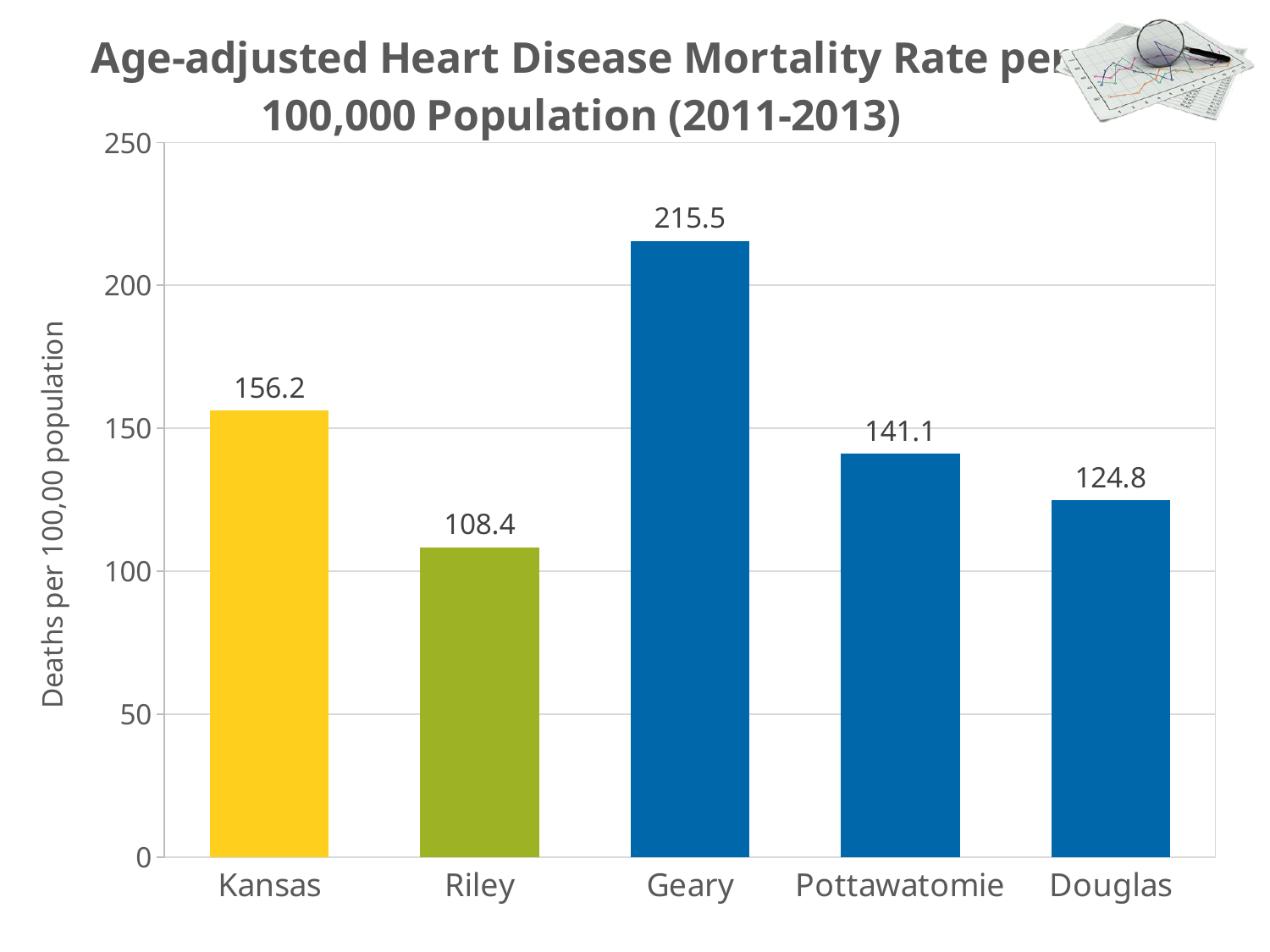
What is the difference between the mortality rates for Geary and Riley? 107.1 What is the age-adjusted heart disease mortality rate for Geary? 215.5 How many categories are shown on the x axis? 5 Which category has the highest heart disease mortality rate? Geary What is the difference between the mortality rates for Kansas and Pottawatomie? 15.1 What kind of chart is shown on the slide? bar chart Which has a higher mortality rate, Pottawatomie or Douglas? Pottawatomie What is the age-adjusted heart disease mortality rate for Kansas? 156.2 What is the age-adjusted heart disease mortality rate for Douglas? 124.8 What is the age-adjusted heart disease mortality rate for Riley? 108.4 Which category has the lowest heart disease mortality rate? Riley Is the value for Geary greater or less than 200? greater